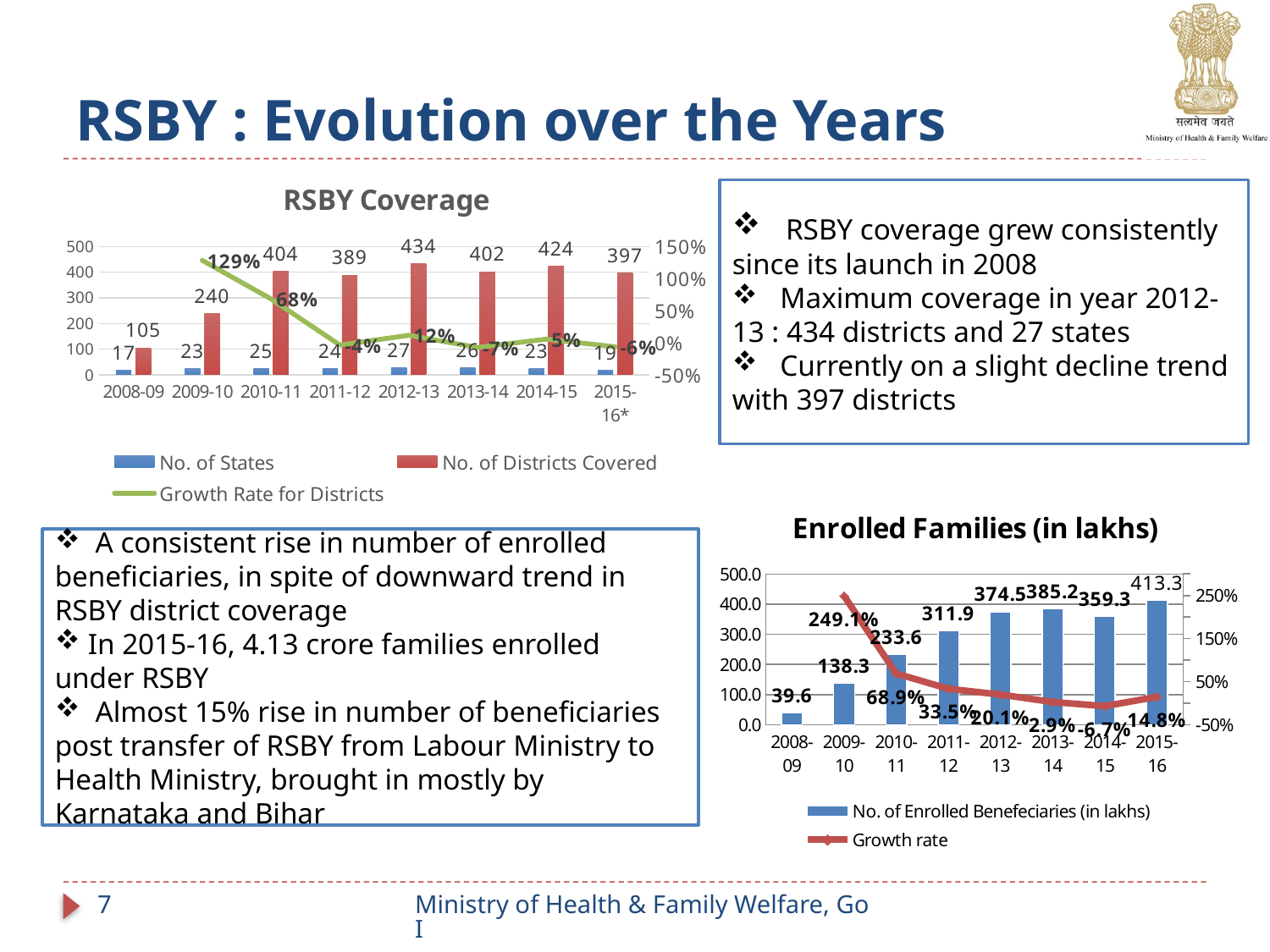
In the RSBY Coverage chart, which year had the highest number of districts covered? 2012-13 In the RSBY Coverage chart, how many districts were covered in 2012-13? 434 In the RSBY Coverage chart, what was the number of states in 2008-09? 17 In the RSBY Coverage chart, what was the growth rate for districts in 2009-10? 129% In the Enrolled Families (in lakhs) chart, how many years are shown on the x axis? 8 In the Enrolled Families (in lakhs) chart, how many enrolled beneficiaries (in lakhs) were there in 2015-16? 413.3 In the Enrolled Families (in lakhs) chart, what was the growth rate in 2013-14? 2.9% In the RSBY Coverage chart, what is the difference in districts covered between 2014-15 and 2015-16*? 27 In the Enrolled Families (in lakhs) chart, which year had the lowest number of enrolled beneficiaries? 2008-09 In the Enrolled Families (in lakhs) chart, does the growth rate line rise or fall from 2008-09 to 2013-14? fall In the Enrolled Families (in lakhs) chart, which is larger: enrolled beneficiaries in 2012-13 or in 2014-15? 2012-13 In the RSBY Coverage chart, how many series does the legend list? 3